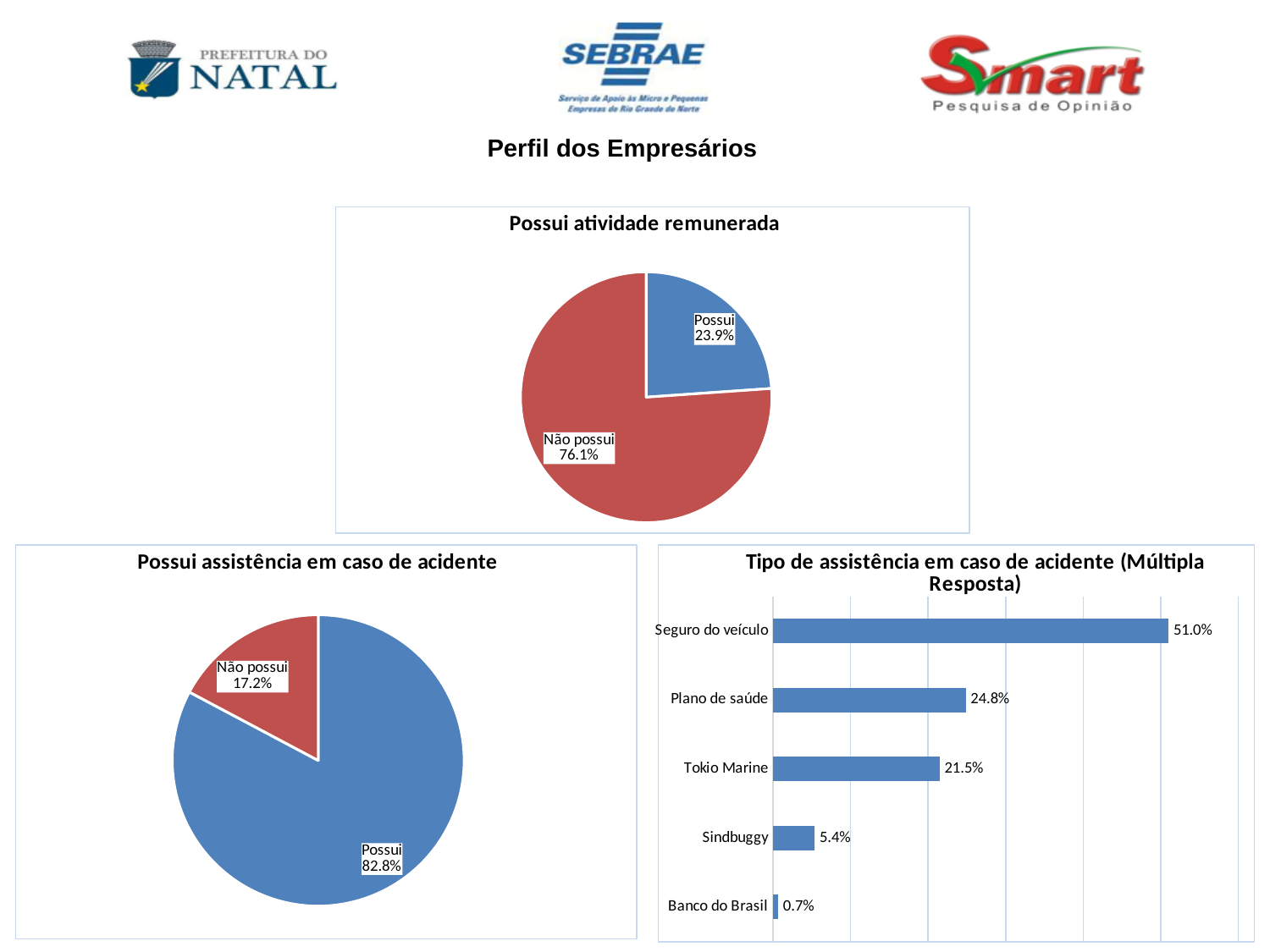
In the 'Tipo de assistência em caso de acidente (Múltipla Resposta)' chart, what is the value for 'Plano de saúde'? 24.8% In the 'Possui atividade remunerada' chart, what percentage is shown for 'Possui'? 23.9% In the 'Possui atividade remunerada' chart, which slice is larger, 'Possui' or 'Não possui'? Não possui In the 'Possui assistência em caso de acidente' chart, what is the difference between 'Possui' and 'Não possui'? 65.6% What kind of chart is 'Possui assistência em caso de acidente'? Pie chart In the 'Tipo de assistência em caso de acidente (Múltipla Resposta)' chart, what is the difference between 'Seguro do veículo' and 'Tokio Marine'? 29.5% What kind of chart is 'Tipo de assistência em caso de acidente (Múltipla Resposta)'? Bar chart In the 'Possui atividade remunerada' chart, what percentage is shown for 'Não possui'? 76.1% In the 'Tipo de assistência em caso de acidente (Múltipla Resposta)' chart, which category has the highest value? Seguro do veículo In the 'Tipo de assistência em caso de acidente (Múltipla Resposta)' chart, how many categories are shown? 5 In the 'Possui assistência em caso de acidente' chart, what percentage is shown for 'Não possui'? 17.2% In the 'Tipo de assistência em caso de acidente (Múltipla Resposta)' chart, which category has the lowest value? Banco do Brasil